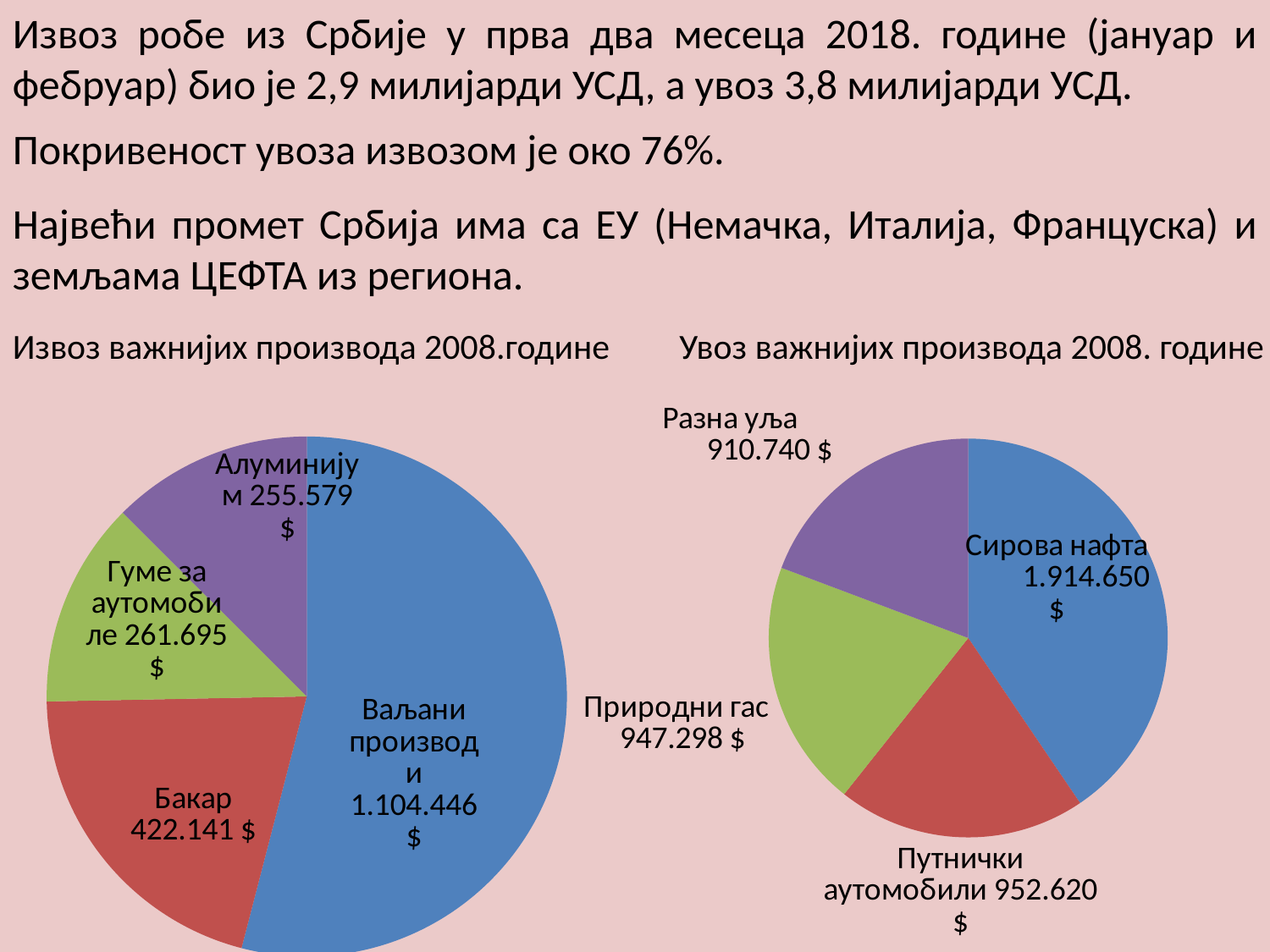
In the 'Извоз важнијих производа 2008.године' chart, which category has the largest value? Ваљани производи In the 'Увоз важнијих производа 2008. године' chart, how many categories are shown? 4 What type of chart is used for 'Извоз важнијих производа 2008.године'? pie chart In the 'Извоз важнијих производа 2008.године' chart, how many categories are shown? 4 In the 'Извоз важнијих производа 2008.године' chart, what is the value for Бакар? 422.141 $ In the 'Извоз важнијих производа 2008.године' chart, what is the difference between Бакар and Гуме за аутомобиле? 160.446 $ In the 'Увоз важнијих производа 2008. године' chart, what is the difference between Сирова нафта and Путнички аутомобили? 962.030 $ In the 'Извоз важнијих производа 2008.године' chart, which is larger: Гуме за аутомобиле or Алуминијум? Гуме за аутомобиле In the 'Увоз важнијих производа 2008. године' chart, what colour is the Сирова нафта slice? blue In the 'Увоз важнијих производа 2008. године' chart, which category has the smallest value? Разна уља In the 'Увоз важнијих производа 2008. године' chart, which category has the largest value? Сирова нафта In the 'Увоз важнијих производа 2008. године' chart, what is the value for Природни гас? 947.298 $